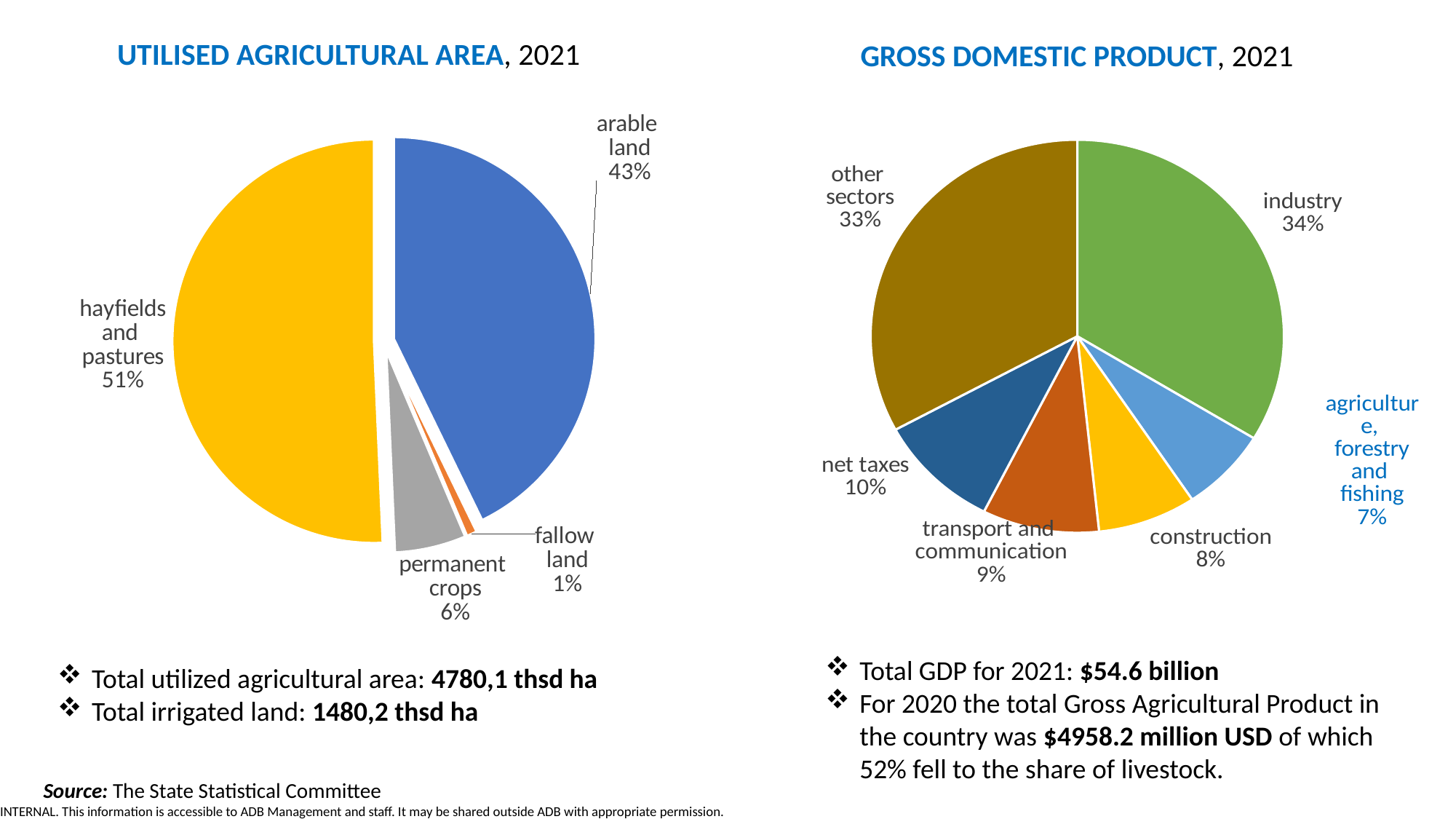
In the GROSS DOMESTIC PRODUCT, 2021 chart, what share is industry? 34% In the UTILISED AGRICULTURAL AREA, 2021 chart, how many categories are shown? 4 In the UTILISED AGRICULTURAL AREA, 2021 chart, which category has the smallest share? fallow land In the GROSS DOMESTIC PRODUCT, 2021 chart, what share is agriculture, forestry and fishing? 7% What kind of chart is the GROSS DOMESTIC PRODUCT, 2021 chart? pie chart In the UTILISED AGRICULTURAL AREA, 2021 chart, what share is arable land? 43% In the UTILISED AGRICULTURAL AREA, 2021 chart, what share is hayfields and pastures? 51% In the GROSS DOMESTIC PRODUCT, 2021 chart, how many sectors are shown? 6 In the GROSS DOMESTIC PRODUCT, 2021 chart, which is larger, net taxes or construction? net taxes In the UTILISED AGRICULTURAL AREA, 2021 chart, what is the difference in percentage points between hayfields and pastures and permanent crops? 45 percentage points In the GROSS DOMESTIC PRODUCT, 2021 chart, which sector has the largest share? industry In the UTILISED AGRICULTURAL AREA, 2021 chart, which category has the largest share? hayfields and pastures